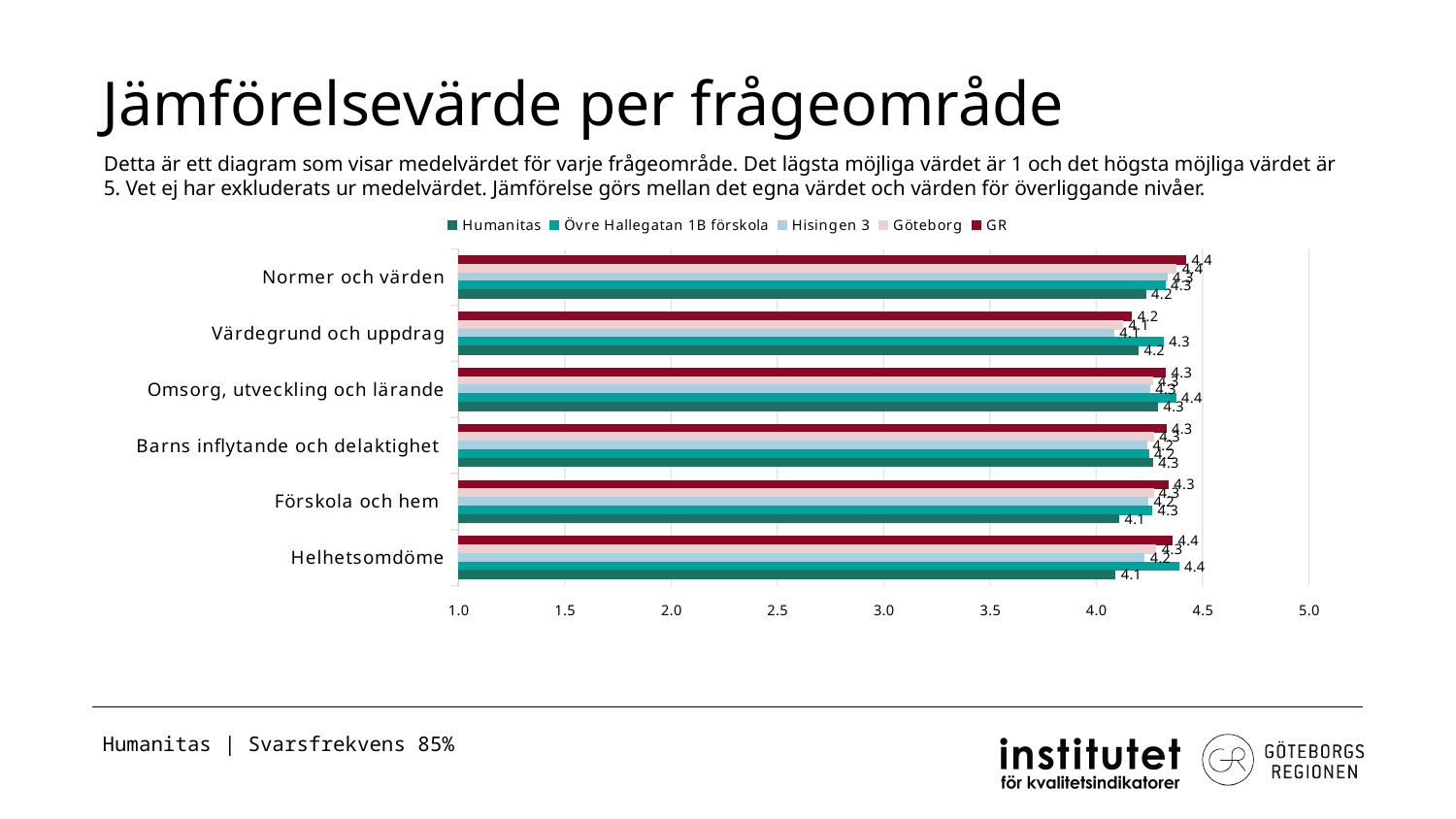
How many series does the legend list? 5 What is the value for Humanitas in Förskola och hem? 4.1 What is the value for GR in Värdegrund och uppdrag? 4.2 How many question areas (categories) are shown on the y axis? 6 What is the value for Humanitas in Helhetsomdöme? 4.1 In Helhetsomdöme, which is larger: the value for Humanitas or the value for Övre Hallegatan 1B förskola? Övre Hallegatan 1B förskola Is the value for Humanitas in Förskola och hem greater or less than 4.5? less In Helhetsomdöme, what is the difference between the value for Övre Hallegatan 1B förskola and the value for Humanitas? 0.3 What is the value for Humanitas in Normer och värden? 4.2 What is the value for Övre Hallegatan 1B förskola in Omsorg, utveckling och lärande? 4.4 Which series is listed first in the legend? Humanitas What kind of chart is shown on the slide? bar chart